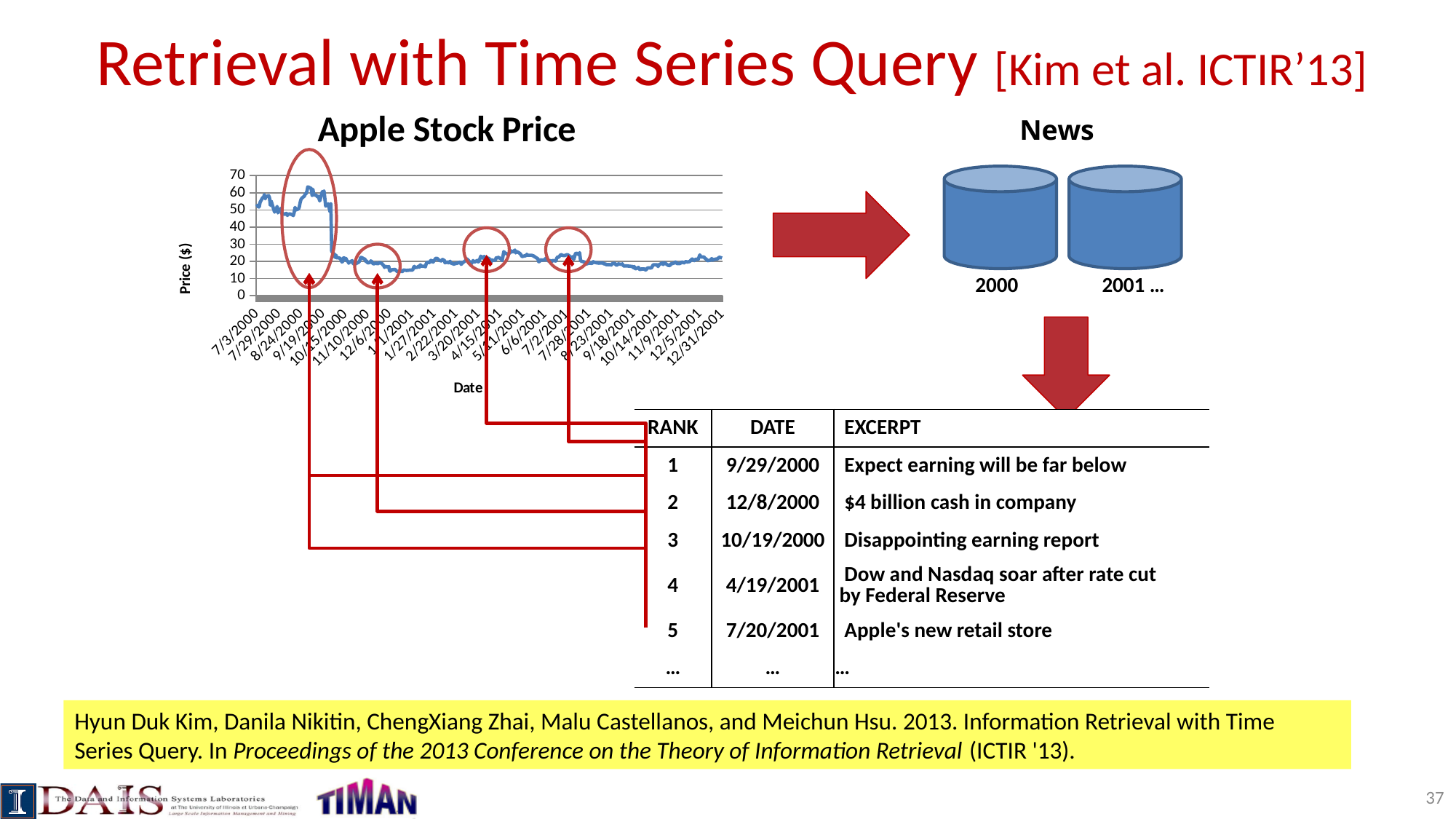
Is the value for 12/6/2000 in the Apple Stock Price chart greater or less than 30? less How many date labels are shown on the x axis of the Apple Stock Price chart? 22 What is the label of the y axis of the Apple Stock Price chart? Price ($) What kind of chart is the Apple Stock Price chart? line chart What is the title of the chart on the slide? Apple Stock Price Which has the larger value in the Apple Stock Price chart, 9/19/2000 or 12/6/2000? 9/19/2000 Is the value for 7/3/2000 in the Apple Stock Price chart greater or less than 40? greater Is the value for 12/31/2001 in the Apple Stock Price chart greater or less than 40? less Which has the larger value in the Apple Stock Price chart, 7/3/2000 or 12/31/2001? 7/3/2000 What is the highest tick value shown on the y axis of the Apple Stock Price chart? 70 Overall, does the Apple Stock Price rise or fall from 7/3/2000 to 12/31/2001? fall